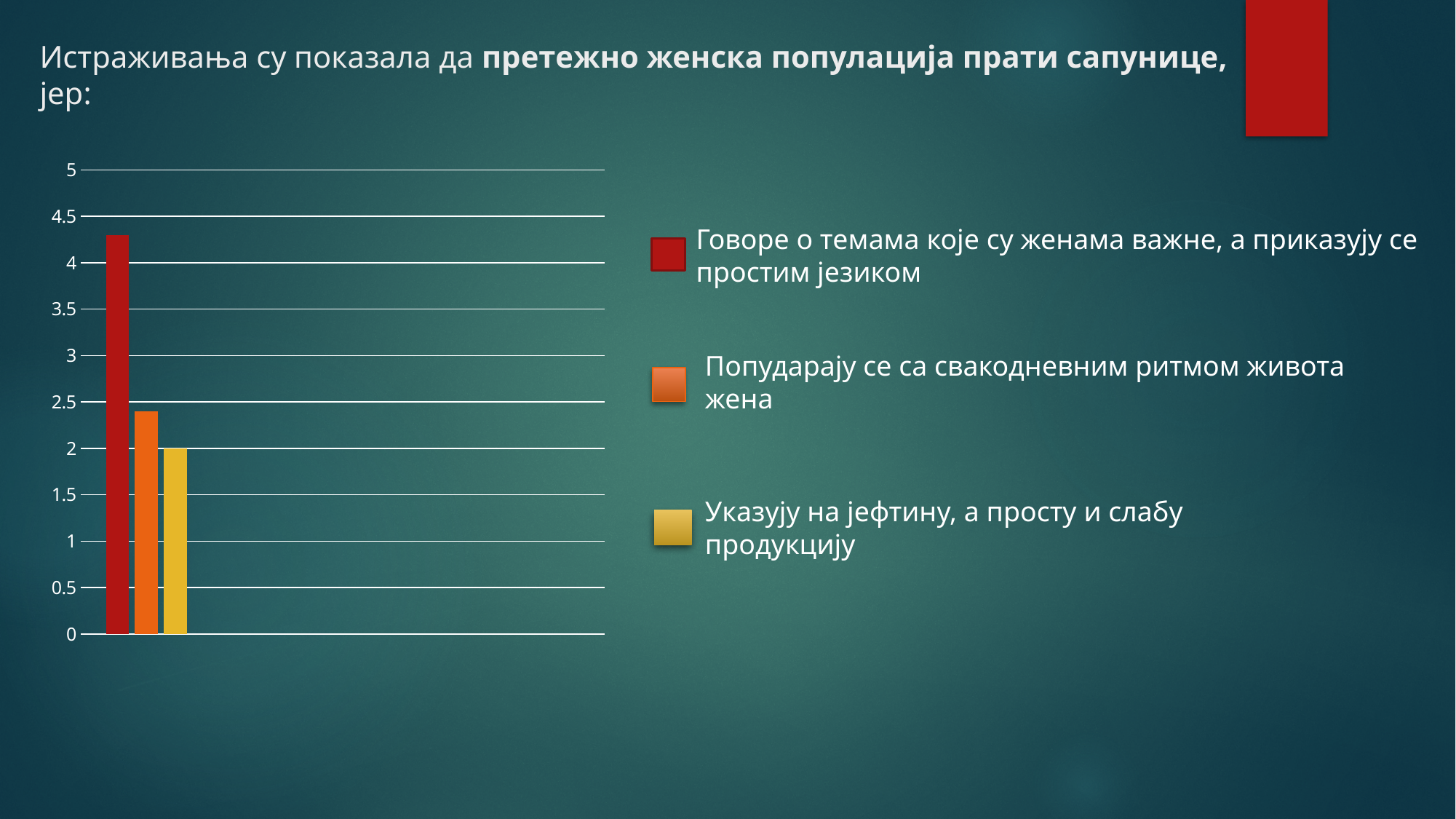
What is the highest value shown on the vertical axis? 5 Is the value of the orange bar (Попударају се са свакодневним ритмом живота жена) greater or less than 3? less Which is larger: the orange bar or the yellow bar? the orange bar Which bar is the highest in the chart? the red bar (Говоре о темама које су женама важне, а приказују се простим језиком) Is the value of the orange bar (Попударају се са свакодневним ритмом живота жена) greater or less than 2? greater Is the value of the red bar (Говоре о темама које су женама важне) greater or less than 4? greater Which is larger: the red bar or the orange bar? the red bar Which bar is the lowest in the chart? the yellow bar (Указују на јефтину, а просту и слабу продукцију) What kind of chart is shown on the slide? bar chart How many bars are plotted in the chart? 3 What colour is the bar for 'Попударају се са свакодневним ритмом живота жена'? orange What is the value of the yellow bar (Указују на јефтину, а просту и слабу продукцију)? 2